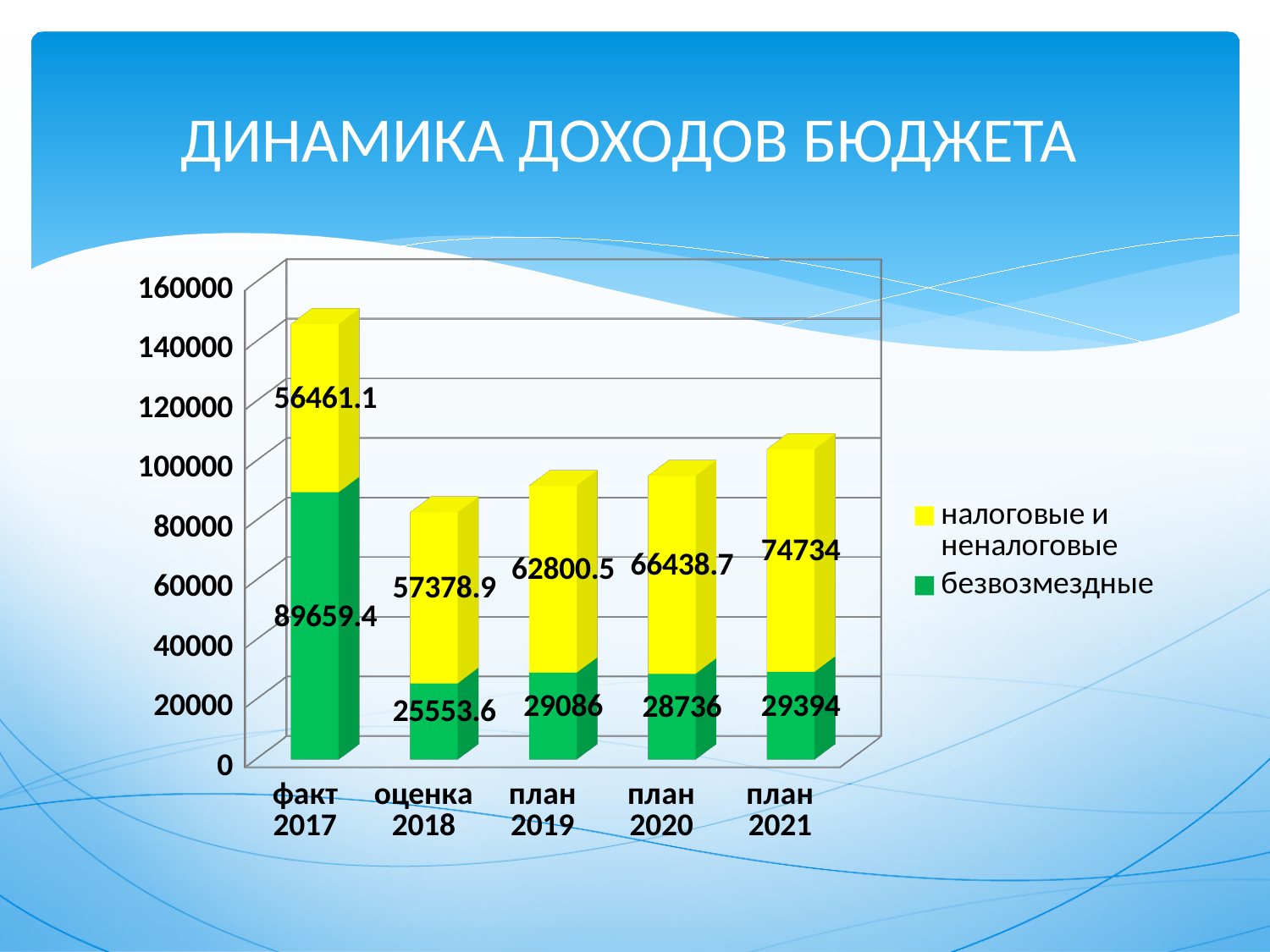
Which is larger: безвозмездные for план 2019 or for план 2020? план 2019 Which category has the lowest value for налоговые и неналоговые? факт 2017 What kind of chart is shown on the slide? Stacked bar chart What is the total of the stacked bar for план 2021? 104128 What is the value of налоговые и неналоговые for оценка 2018? 57378.9 What is the value of налоговые и неналоговые for план 2021? 74734 How many categories are shown on the x axis? 5 What is the total of the stacked bar for оценка 2018? 82932.5 How many series does the legend list? 2 Which category has the highest value for безвозмездные? факт 2017 What is the difference between the налоговые и неналоговые values for план 2021 and план 2020? 8295.3 What is the value of безвозмездные for факт 2017? 89659.4